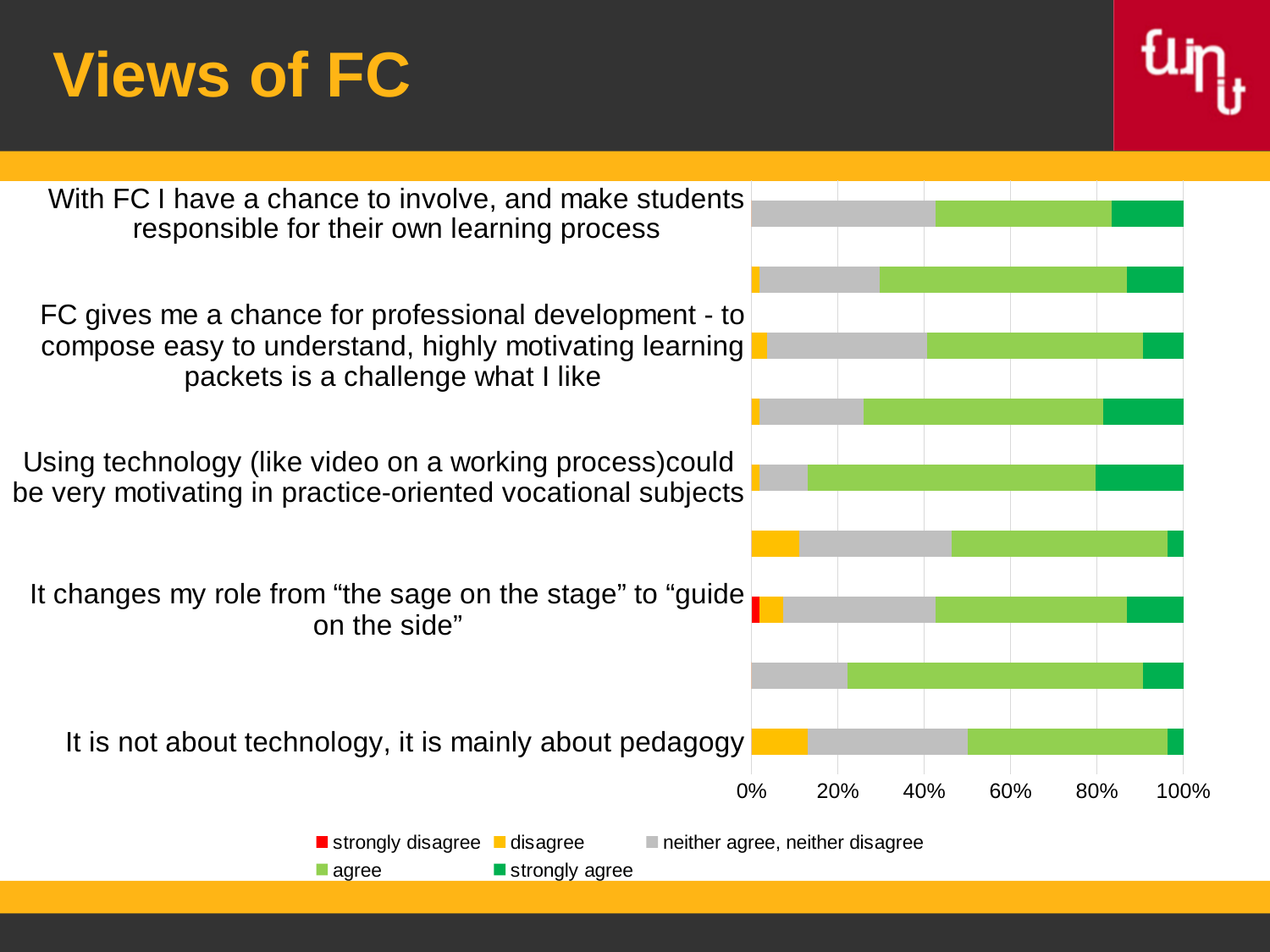
Which legend entry is shown in red? strongly disagree What kind of chart is shown on the slide? stacked bar chart Which labelled statement is the only one with a 'strongly disagree' segment? It changes my role from "the sage on the stage" to "guide on the side" Among the labelled statements, which has the largest 'disagree' segment? It is not about technology, it is mainly about pedagogy What is the highest value shown on the percentage axis? 100% Among the labelled statements, which has the smallest 'strongly agree' segment? It is not about technology, it is mainly about pedagogy Is the 'disagree' segment for 'It is not about technology, it is mainly about pedagogy' greater or less than 20%? less How many bars are plotted in the chart? 9 Does the 'neither agree, neither disagree' segment for 'It is not about technology, it is mainly about pedagogy' end past 40% or before 40%? past 40% Which has the larger 'neither agree, neither disagree' segment: 'With FC I have a chance to involve, and make students responsible for their own learning process' or 'Using technology (like video on a working process)could be very motivating in practice-oriented vocational subjects'? With FC I have a chance to involve, and make students responsible for their own learning process How many series does the legend list? 5